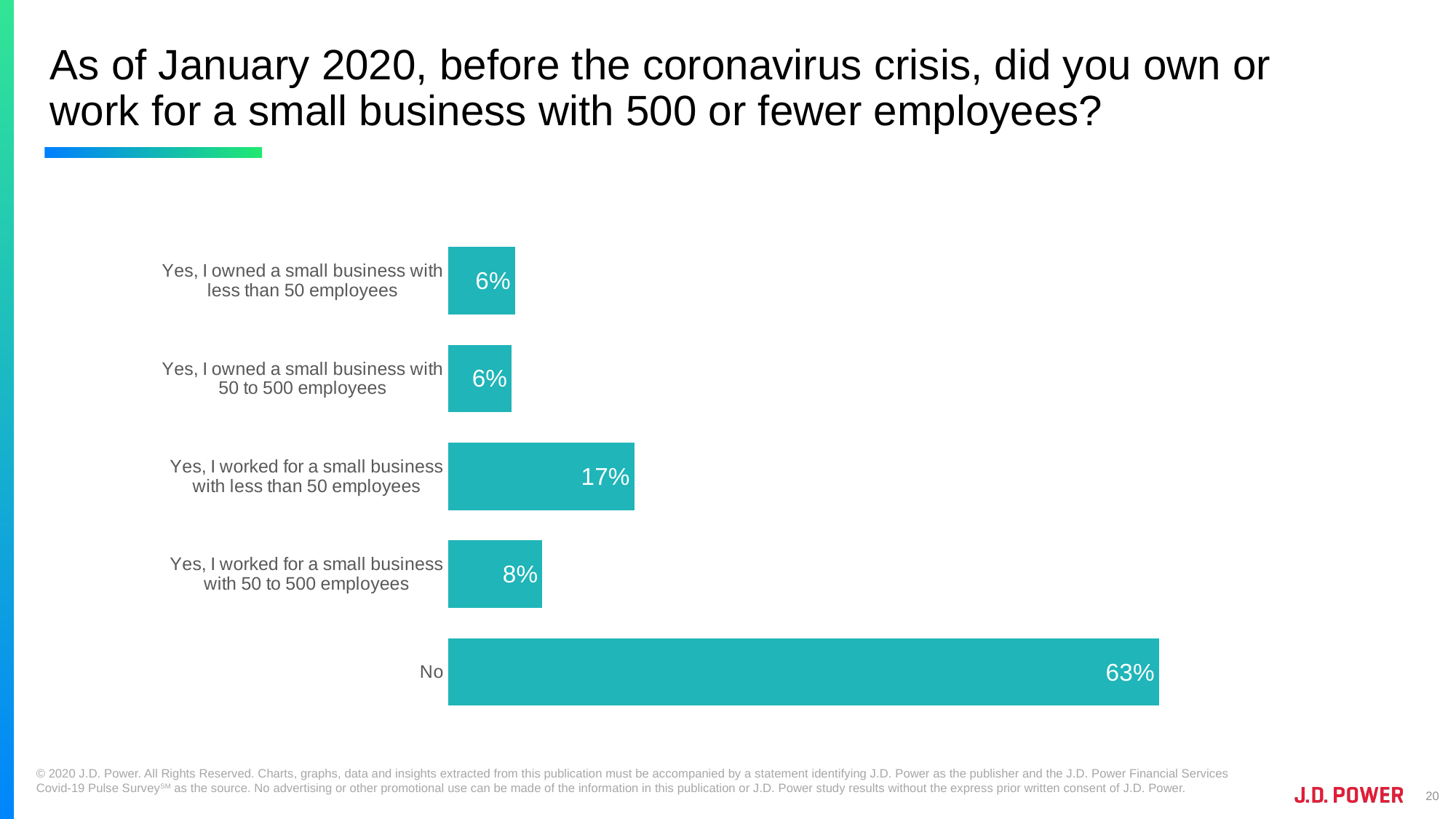
What colour are the bars in the chart? Teal Which is larger: the percentage who worked for a small business with less than 50 employees or the percentage who worked for a small business with 50 to 500 employees? Yes, I worked for a small business with less than 50 employees How many response categories are shown in the chart? 5 What is the difference in percentage points between "No" and "Yes, I worked for a small business with less than 50 employees"? 46 What percentage of respondents said they owned a small business with less than 50 employees? 6% Which response category has the highest percentage? No What percentage of respondents said they worked for a small business with 50 to 500 employees? 8% What type of chart is shown on the slide? Bar chart What percentage of respondents answered "No"? 63% What is the difference in percentage points between "Yes, I worked for a small business with less than 50 employees" and "Yes, I worked for a small business with 50 to 500 employees"? 9 What percentage of respondents said they worked for a small business with less than 50 employees? 17% What is the combined percentage of respondents who said they owned a small business (either size)? 12%